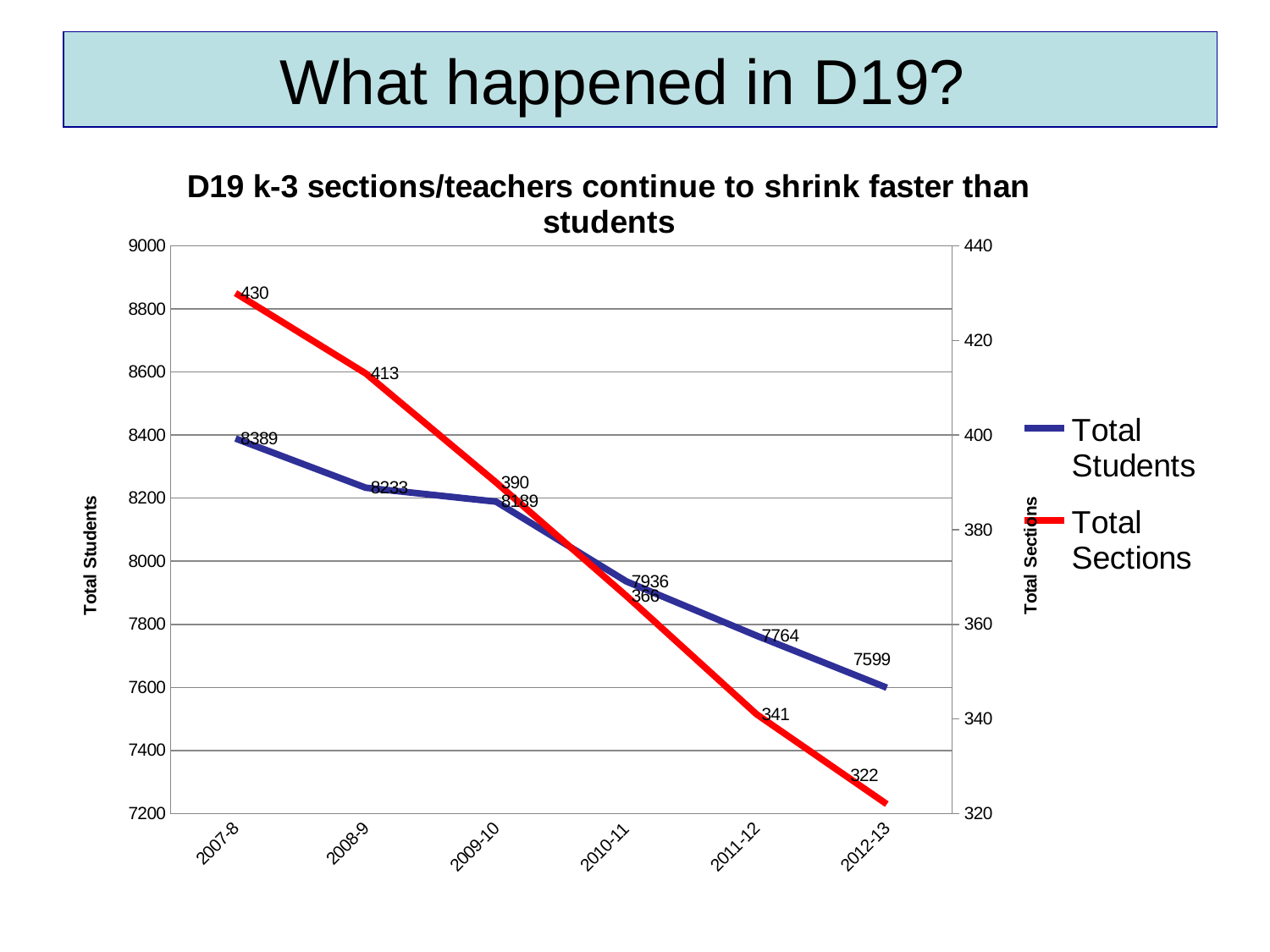
What is the value of Total Sections for 2012-13? 322 What is the value of Total Students for 2011-12? 7764 What kind of chart is shown on the slide? Line chart In which year is Total Students lowest? 2012-13 What is the value of Total Sections for 2008-9? 413 Which year has more Total Sections, 2009-10 or 2011-12? 2009-10 By how much did Total Students fall from 2007-8 to 2012-13? 790 How many school years are plotted on the x axis? 6 What is the value of Total Students for 2007-8? 8389 In which year is Total Sections highest? 2007-8 How many series does the legend list? 2 By how much did Total Sections fall from 2007-8 to 2012-13? 108